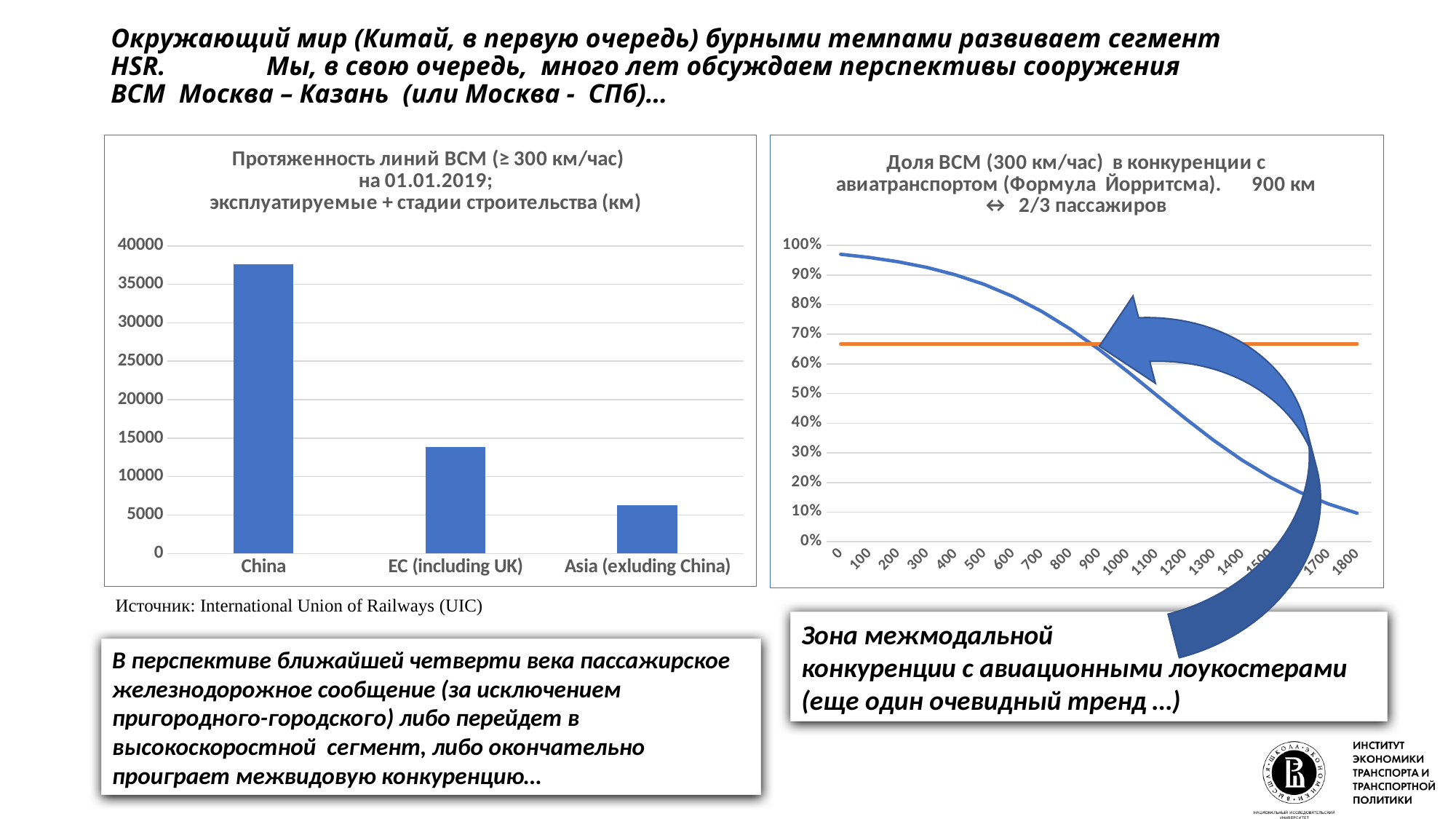
In the right chart (Доля ВСМ в конкуренции с авиатранспортом), does the blue curve rise or fall as distance increases along the x axis? fall In the right chart (Доля ВСМ в конкуренции с авиатранспортом), is the value of the blue curve at 1800 greater or less than 20%? less In the left chart (Протяженность линий ВСМ), how many categories are shown on the x axis? 3 In the right chart (Доля ВСМ в конкуренции с авиатранспортом), what is the highest value shown on the y axis? 100% In the left chart (Протяженность линий ВСМ), what is the source cited below the chart? International Union of Railways (UIC) In the left chart (Протяженность линий ВСМ), is the value for EC (including UK) greater or less than 15000? less In the left chart (Протяженность линий ВСМ), which category has the lowest value? Asia (exluding China) In the left chart (Протяженность линий ВСМ), is the value for Asia (exluding China) greater or less than 5000? greater In the left chart (Протяженность линий ВСМ), what kind of chart is shown? bar chart In the left chart (Протяженность линий ВСМ), which category has the highest value? China In the left chart (Протяженность линий ВСМ), which is larger: the value for EC (including UK) or the value for Asia (exluding China)? EC (including UK)